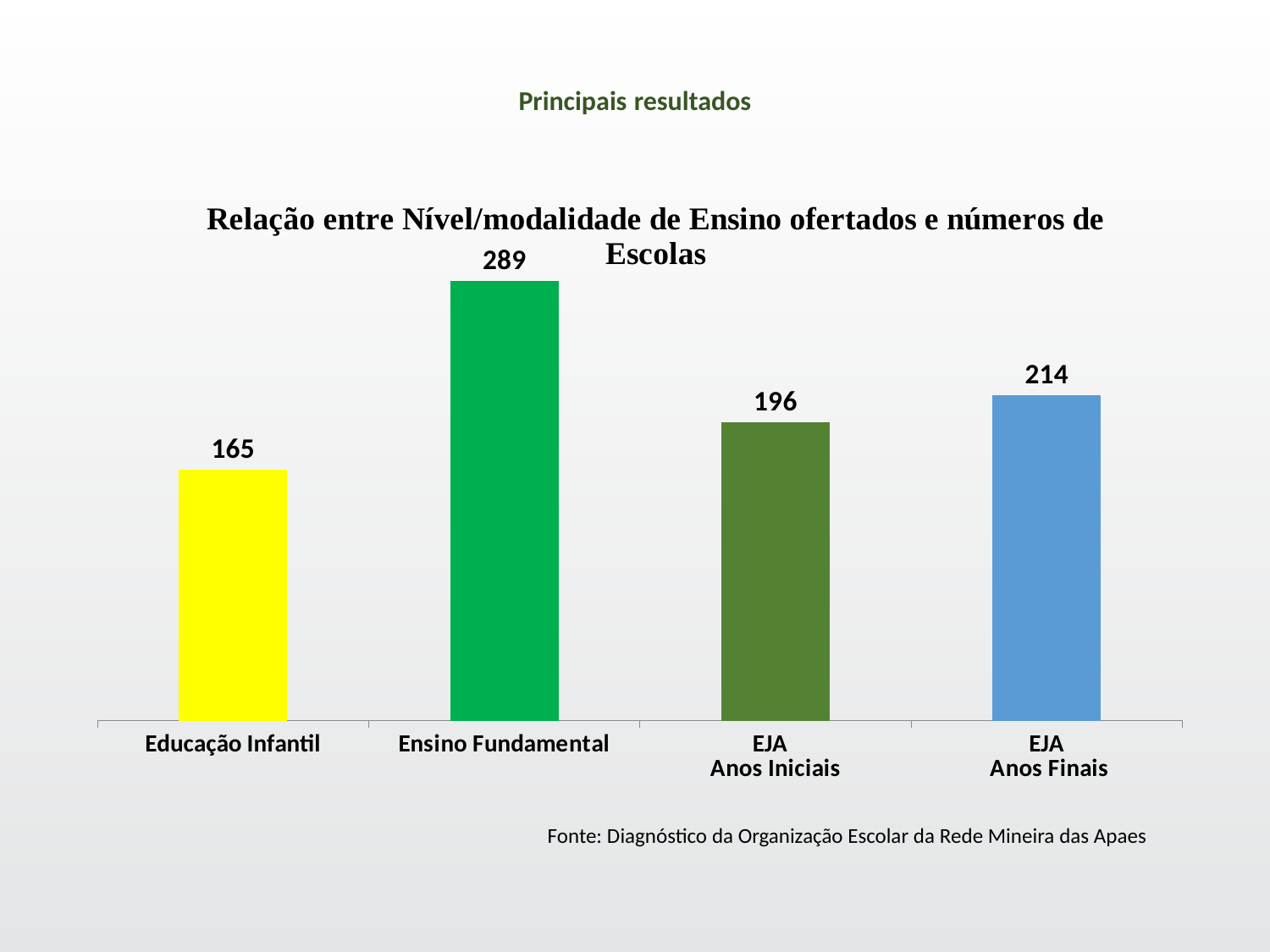
What colour is the bar for Educação Infantil? Yellow How many categories are shown in the chart? 4 What is the value for EJA Anos Iniciais? 196 Which is larger, the value for EJA Anos Iniciais or EJA Anos Finais? EJA Anos Finais What is the difference between the values for Ensino Fundamental and Educação Infantil? 124 What is the value for Educação Infantil? 165 What is the value for EJA Anos Finais? 214 What kind of chart is shown on the slide? Bar chart What is the difference between the values for EJA Anos Finais and EJA Anos Iniciais? 18 Which category has the lowest value? Educação Infantil Which category has the highest value? Ensino Fundamental What is the value for Ensino Fundamental? 289